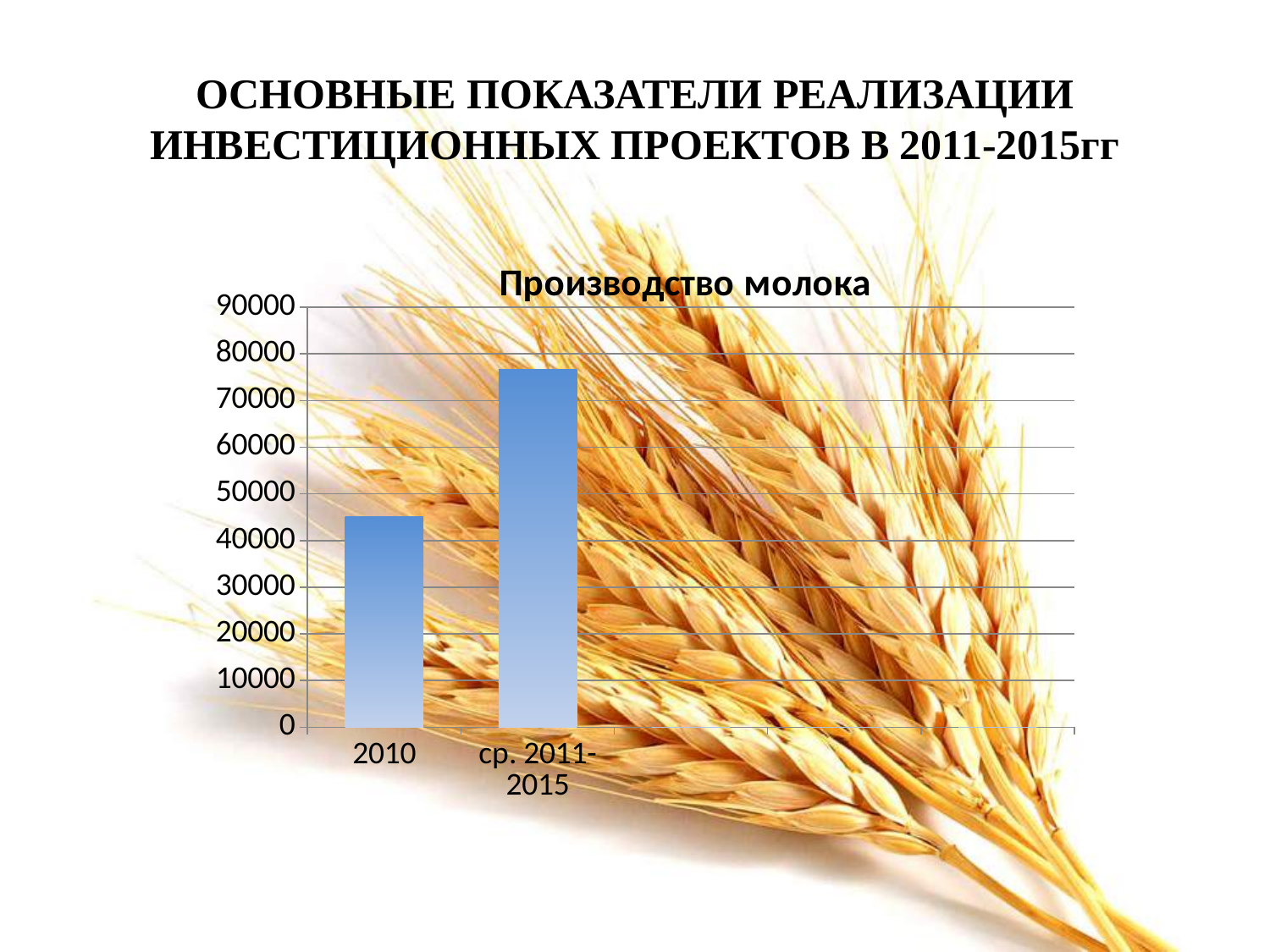
Which category has the highest value in the chart? ср. 2011-2015 What is the highest value shown on the vertical axis of the chart? 90000 How many categories are plotted on the x axis of the chart? 2 Is the value for ср. 2011-2015 greater or less than 80000? less Do the values rise or fall from 2010 to ср. 2011-2015? rise Is the value for 2010 greater or less than 40000? greater What kind of chart is shown on the slide? bar chart What is the title of the chart? Производство молока Is the value for ср. 2011-2015 greater or less than 70000? greater Which is larger, the value for 2010 or the value for ср. 2011-2015? ср. 2011-2015 Which category has the lowest value in the chart? 2010